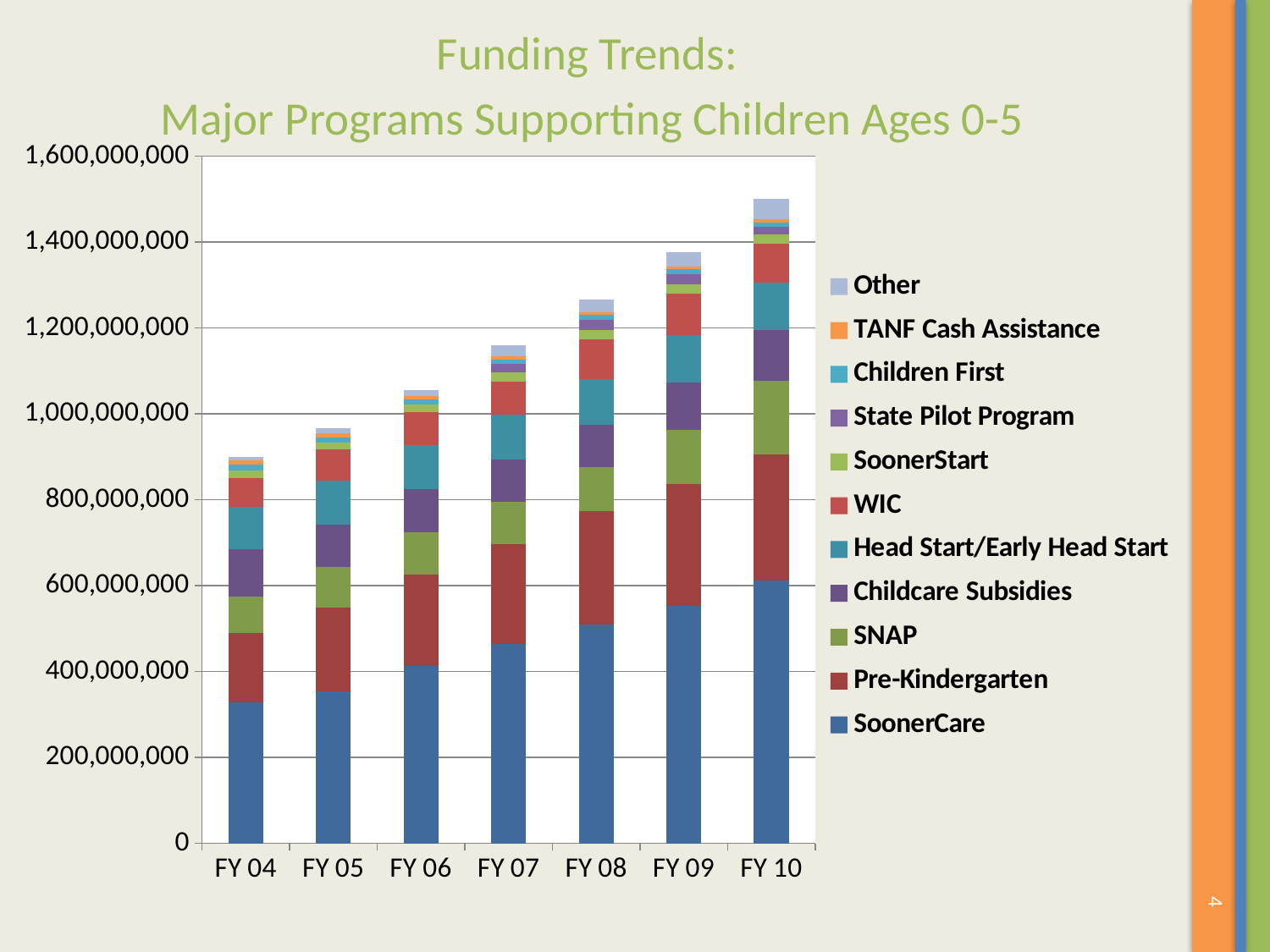
Is the total bar height for FY 04 greater or less than 1,000,000,000? less Which fiscal year has the tallest stacked bar? FY 10 What kind of chart is shown on the slide? stacked bar chart Which has the larger total bar, FY 05 or FY 09? FY 09 Is the total bar height for FY 08 greater or less than 1,200,000,000? greater How many fiscal years are shown on the x axis? 7 Do the total bar heights rise or fall from FY 04 to FY 10? rise Is the total bar height for FY 07 greater or less than 1,000,000,000? greater Which series is shown at the bottom of each stacked bar? SoonerCare How many series does the legend list? 11 Which fiscal year has the shortest stacked bar? FY 04